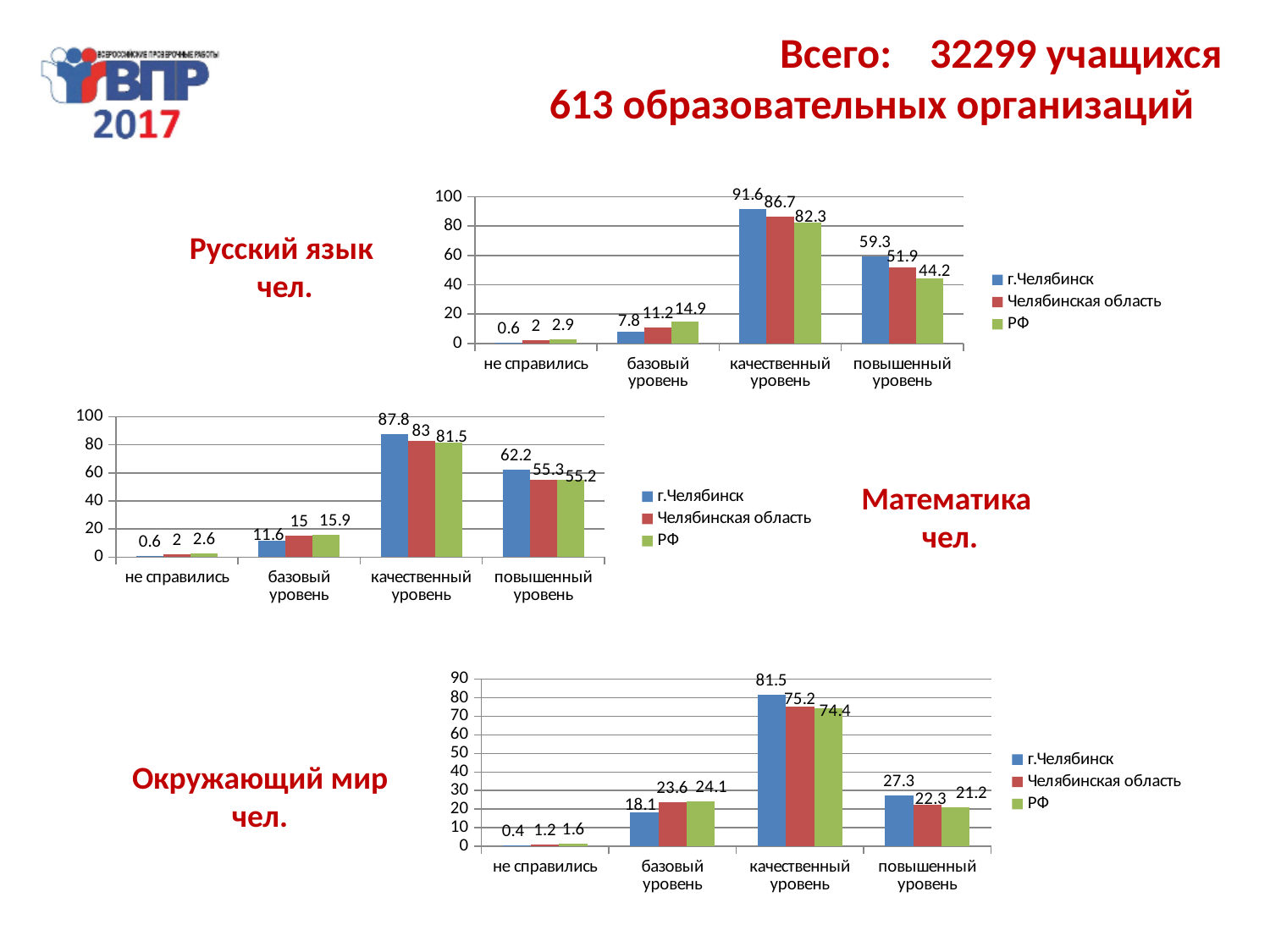
How many categories are shown on the x axis of the Математика chart? 4 In the Математика chart, which series is shown in green in the legend? РФ In the Русский язык chart, what is the value for РФ at повышенный уровень? 44.2 In the Русский язык chart, what is the value for г.Челябинск at качественный уровень? 91.6 In the Окружающий мир chart, which category has the highest value for г.Челябинск? качественный уровень In the Русский язык chart, what is the difference between г.Челябинск and РФ at повышенный уровень? 15.1 What kind of chart is the Окружающий мир chart? bar chart How many series does the legend of the Русский язык chart list? 3 In the Окружающий мир chart, which is larger at базовый уровень: г.Челябинск or РФ? РФ In the Окружающий мир chart, what is the value for г.Челябинск at повышенный уровень? 27.3 In the Математика chart, which category has the lowest value for РФ? не справились In the Математика chart, what is the value for Челябинская область at базовый уровень? 15